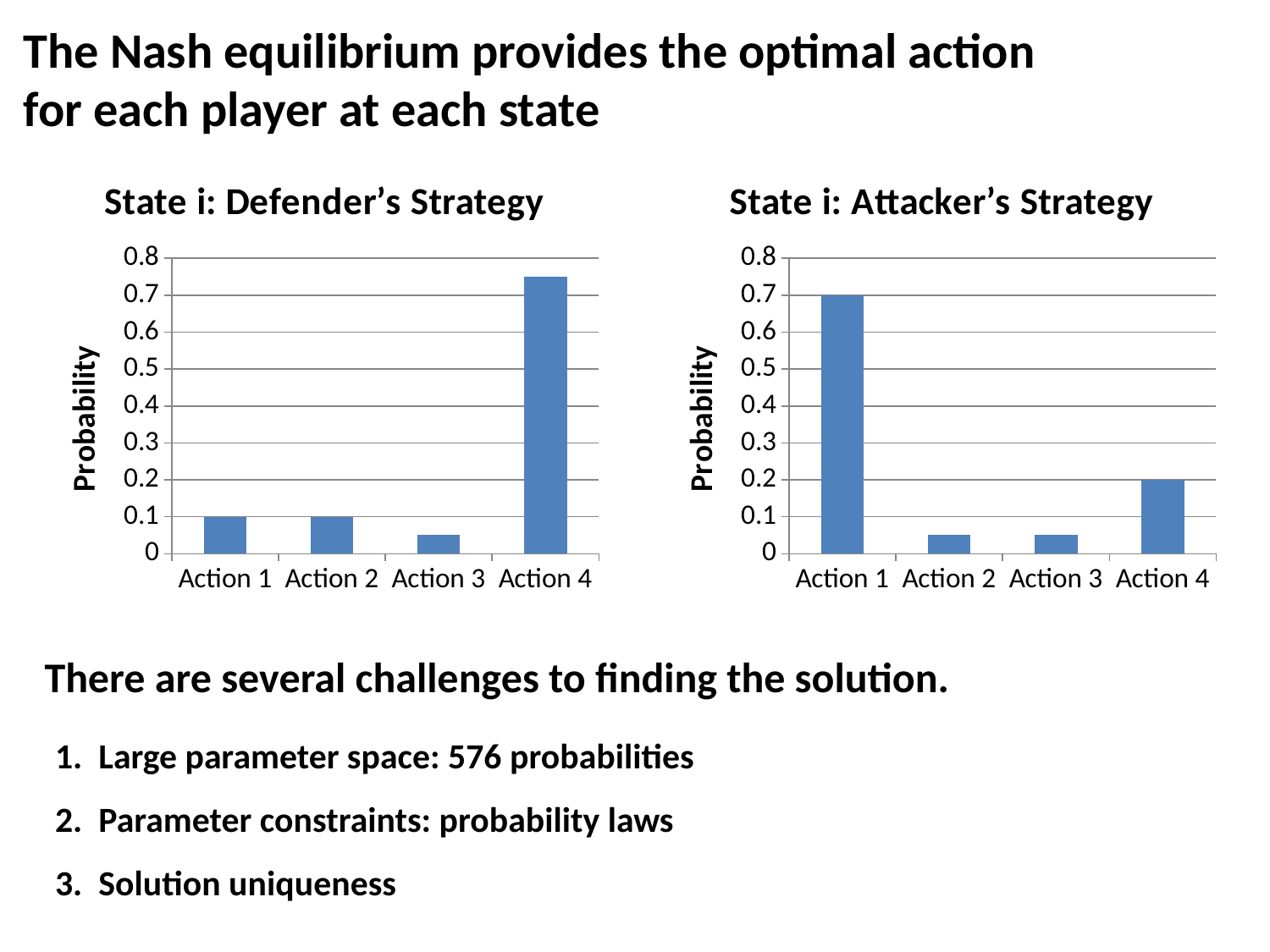
In the State i: Attacker's Strategy chart, which action has the highest probability? Action 1 In the State i: Attacker's Strategy chart, is the probability for Action 2 greater or less than 0.1? less How many actions are shown on the x axis of the State i: Defender's Strategy chart? 4 What type of chart is the State i: Attacker's Strategy chart? Bar chart In the State i: Defender's Strategy chart, is the probability for Action 4 greater or less than 0.7? greater In the State i: Attacker's Strategy chart, what is the difference in probability between Action 1 and Action 4? 0.5 In the State i: Defender's Strategy chart, what is the probability for Action 1? 0.1 In the State i: Defender's Strategy chart, which action has the highest probability? Action 4 In the State i: Defender's Strategy chart, which action has the lowest probability? Action 3 In the State i: Attacker's Strategy chart, what is the probability for Action 4? 0.2 In the State i: Defender's Strategy chart, is the probability for Action 3 greater or less than 0.1? less In the State i: Attacker's Strategy chart, what is the probability for Action 1? 0.7